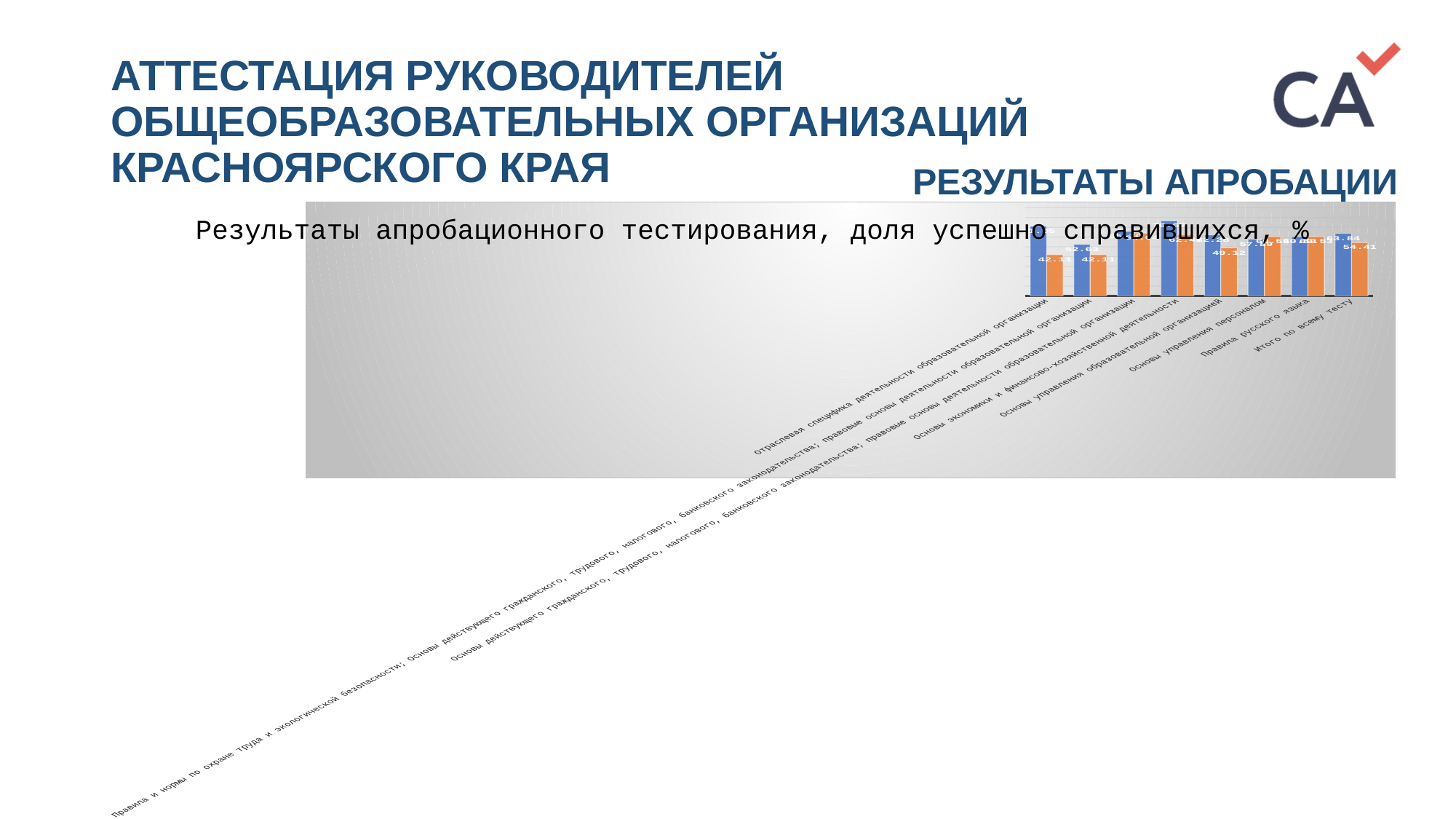
How many data series (bar colours) does the chart show? 2 What is the value of the orange bar for 'Основы управления персоналом'? 60.53 What is the value of the orange bar for 'Основы управления образовательной организацией'? 49.12 What is the title of the chart? Результаты апробационного тестирования, доля успешно справившихся, % For 'Итого по всему тесту', which bar is larger, the blue or the orange one? blue What is the value of the orange bar for 'Итого по всему тесту'? 54.41 What kind of chart is shown on the slide? bar chart How many categories are shown on the x axis of the chart? 8 What is the value of the blue bar for 'Итого по всему тесту'? 63.84 What is the value of the orange bar for 'Отраслевая специфика деятельности образовательной организации'? 42.11